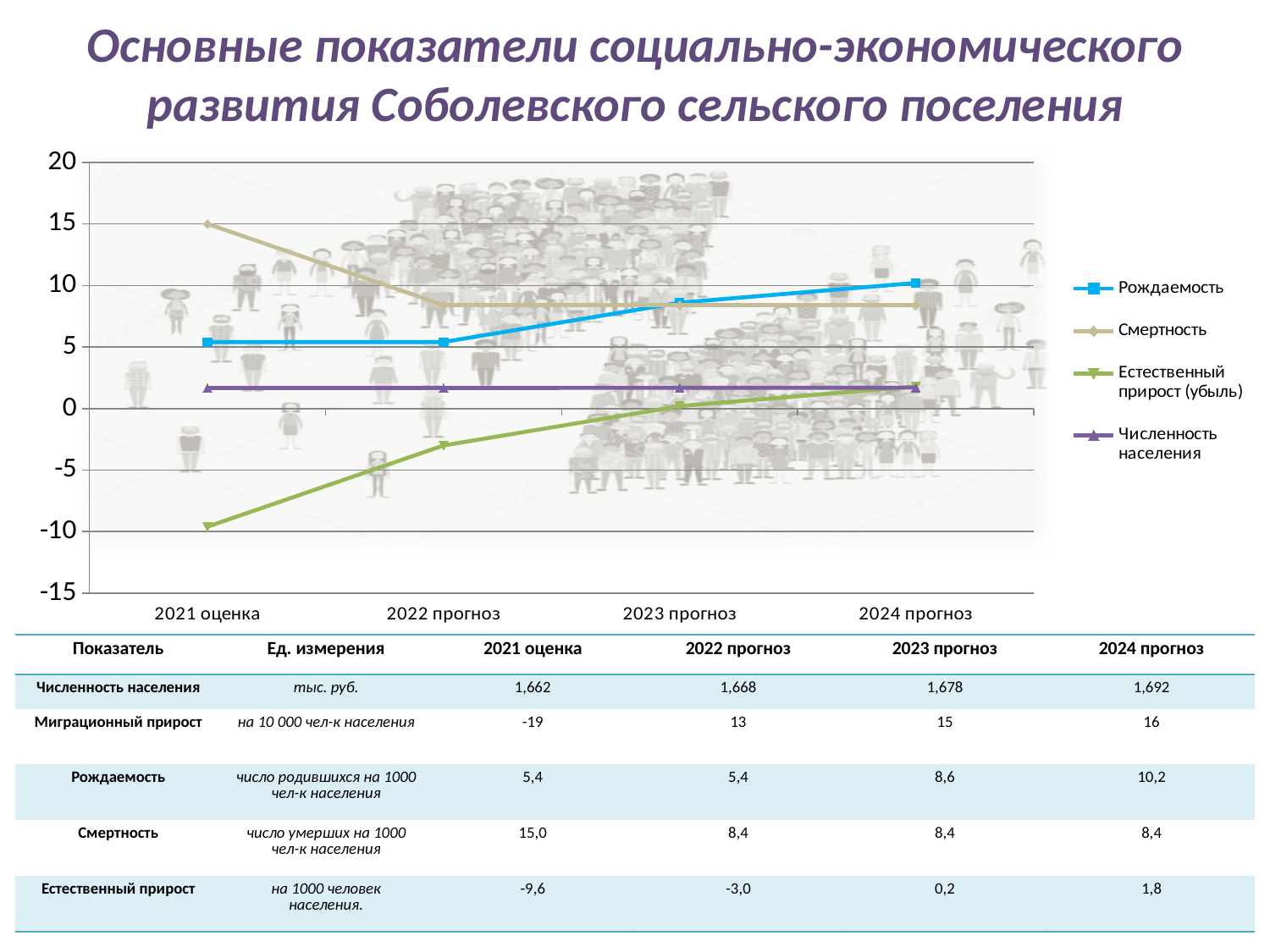
In which year is Смертность highest? 2021 оценка Which is larger in 2024 прогноз, Рождаемость or Смертность? Рождаемость What is the difference between Смертность and Рождаемость in 2021 оценка? 9,6 Is the value of Естественный прирост for 2021 оценка greater or less than -5? less What is the value of Смертность for 2021 оценка? 15,0 What kind of chart is shown on the slide? line chart How many series does the chart legend list? 4 How many x-axis categories does the chart have? 4 In which year is Естественный прирост (убыль) lowest? 2021 оценка What is the value of Рождаемость for 2024 прогноз? 10,2 What is the value of Естественный прирост for 2022 прогноз? -3,0 Does Рождаемость rise or fall from 2022 прогноз to 2024 прогноз? rise